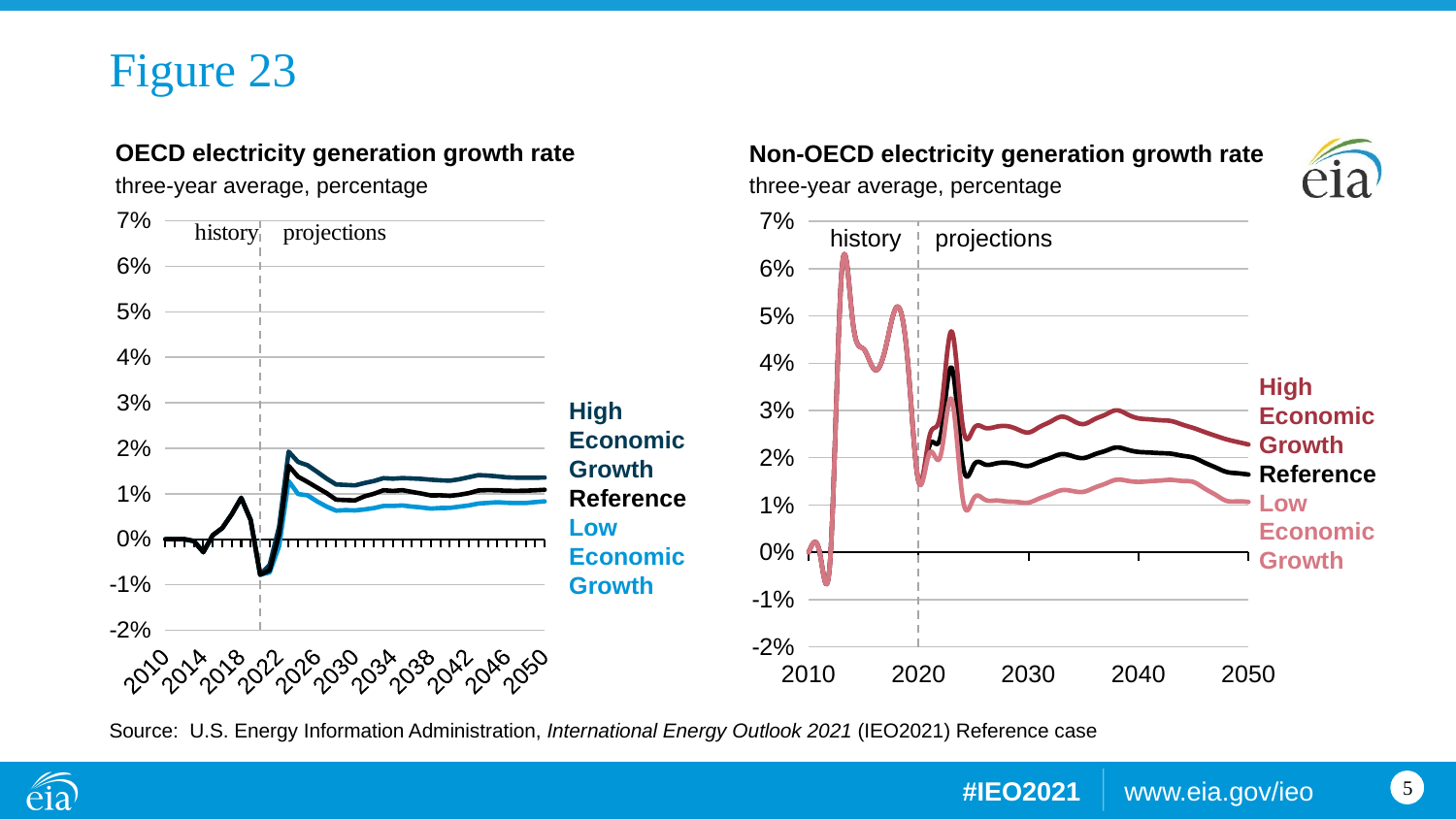
Which chart shows the higher High Economic Growth value in 2050: the OECD chart on the left or the Non-OECD chart on the right? Non-OECD chart What is the subtitle shown under the title of the OECD chart on the left? three-year average, percentage On the Non-OECD chart on the right, is the peak value of the history period (around 2013) greater or less than 5%? greater On the OECD chart on the left, is the value for Low Economic Growth in 2050 greater or less than 0%? greater On the OECD chart on the left, is the value for High Economic Growth in 2050 greater or less than 2%? less On the Non-OECD chart on the right, does the High Economic Growth line rise or fall between 2040 and 2050? fall How many series are labelled on the Non-OECD electricity generation growth rate chart on the right? 3 What kind of chart is the OECD electricity generation growth rate chart on the left? line chart On the Non-OECD chart on the right, what colour is the Reference line? black On the Non-OECD chart on the right, which is larger in 2050: High Economic Growth or Low Economic Growth? High Economic Growth